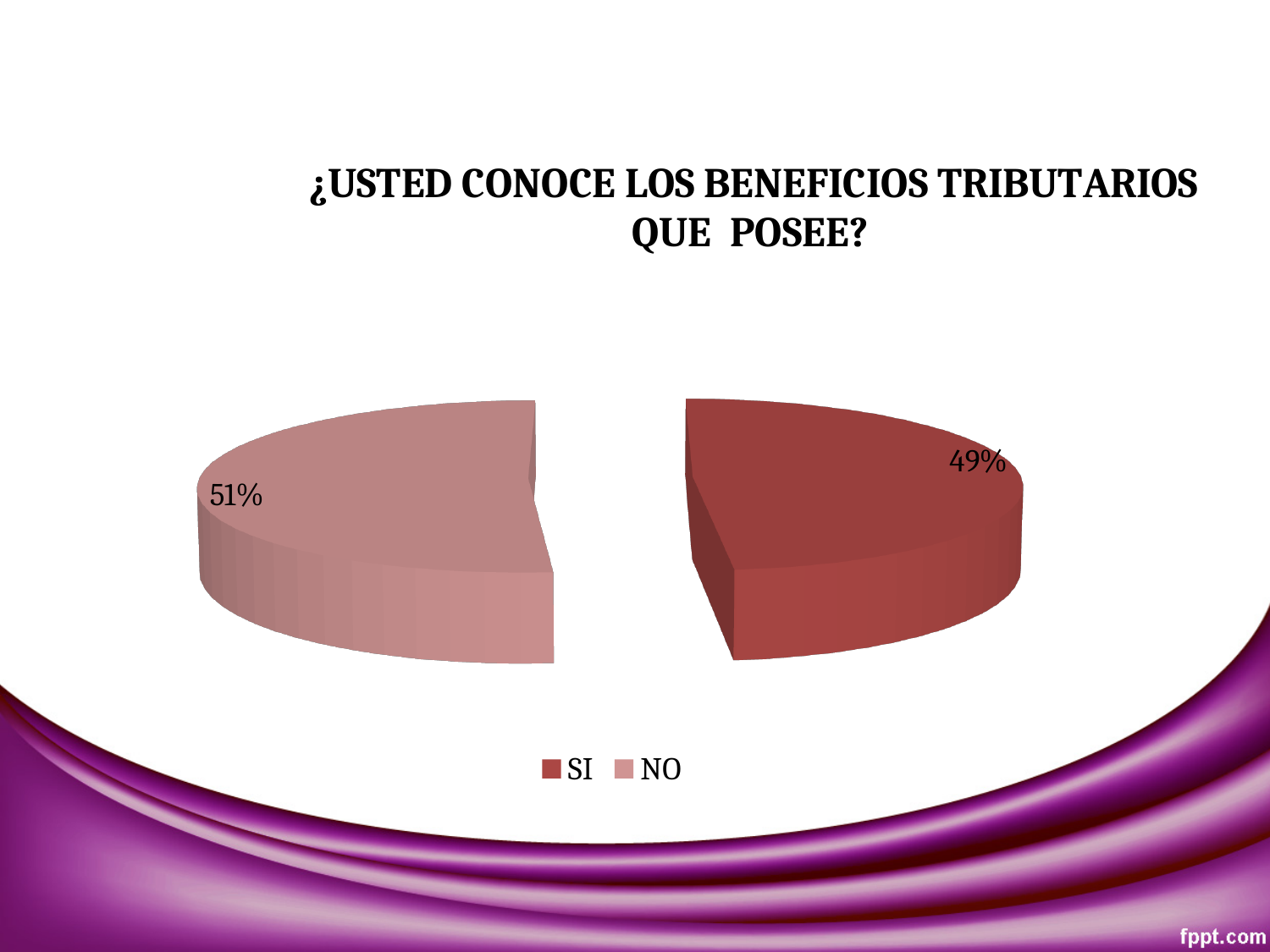
What percentage of respondents answered NO? 51% What is the difference in percentage points between the NO and SI shares? 2% Which response has the smaller share of the pie? SI How many entries does the legend list? 2 Which response has the larger share of the pie? NO What kind of chart is shown on the slide? pie chart How many slices does the pie chart have? 2 Which legend entry is shown in the darker red colour? SI Is the share for NO larger or smaller than the share for SI? larger What is the title of the chart? ¿USTED CONOCE LOS BENEFICIOS TRIBUTARIOS QUE POSEE? What percentage of respondents answered SI? 49%